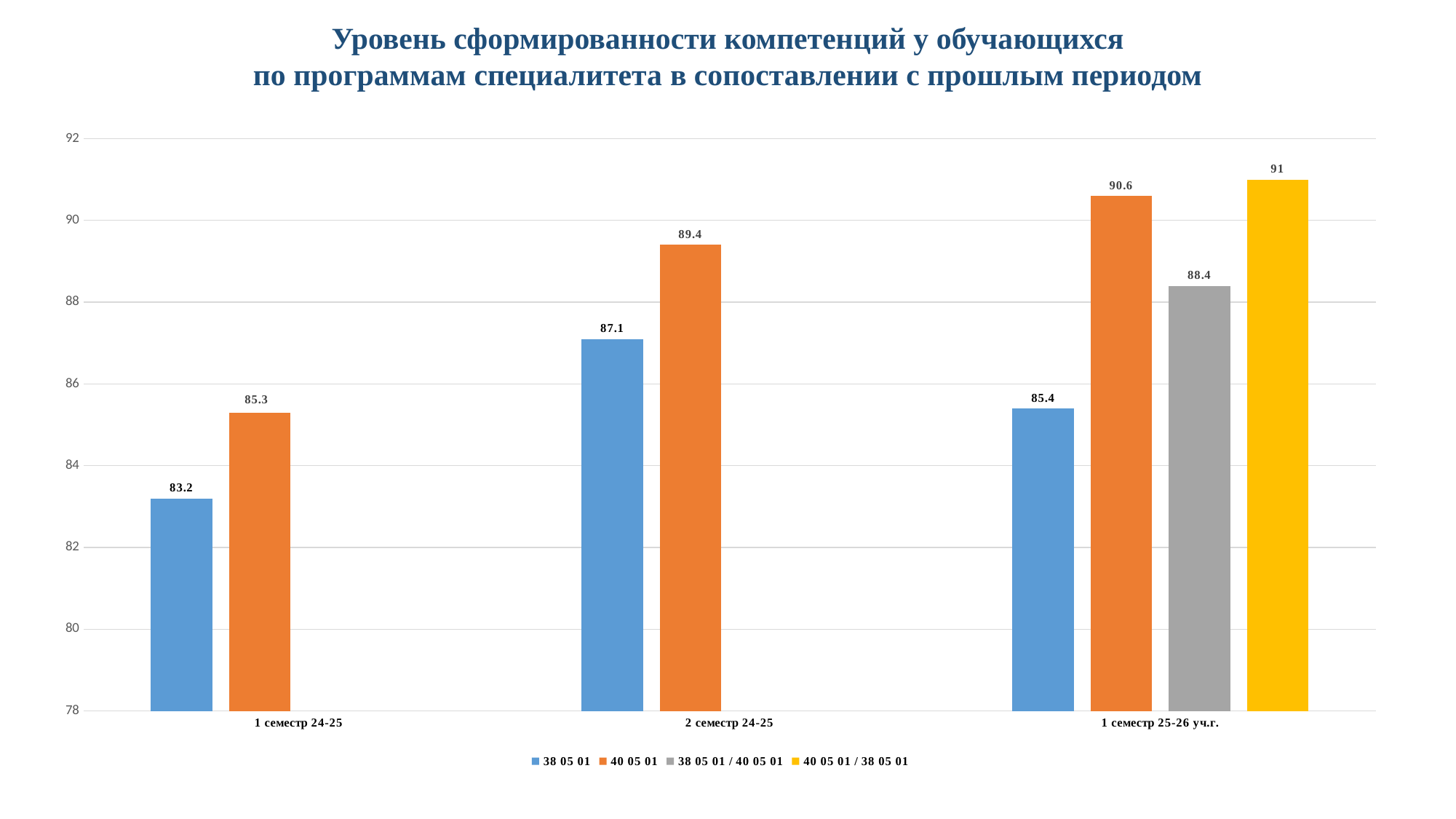
What is the value for series 40 05 01 in 2 семестр 24-25? 89.4 What kind of chart is shown on the slide? bar chart Is the value for 40 05 01 in 1 семестр 24-25 greater or less than 86? less How many series does the legend list? 4 What is the value for series 38 05 01 in 1 семестр 24-25? 83.2 Which bar has the highest value on the chart? 40 05 01 / 38 05 01 in 1 семестр 25-26 уч.г. What is the value for series 40 05 01 / 38 05 01 in 1 семестр 25-26 уч.г.? 91 How many categories are shown on the x axis? 3 Which bar has the lowest value on the chart? 38 05 01 in 1 семестр 24-25 Which is larger in 2 семестр 24-25: the value for 38 05 01 or for 40 05 01? 40 05 01 What is the value for series 38 05 01 / 40 05 01 in 1 семестр 25-26 уч.г.? 88.4 What is the difference between the 40 05 01 and 38 05 01 values in 1 семестр 25-26 уч.г.? 5.2